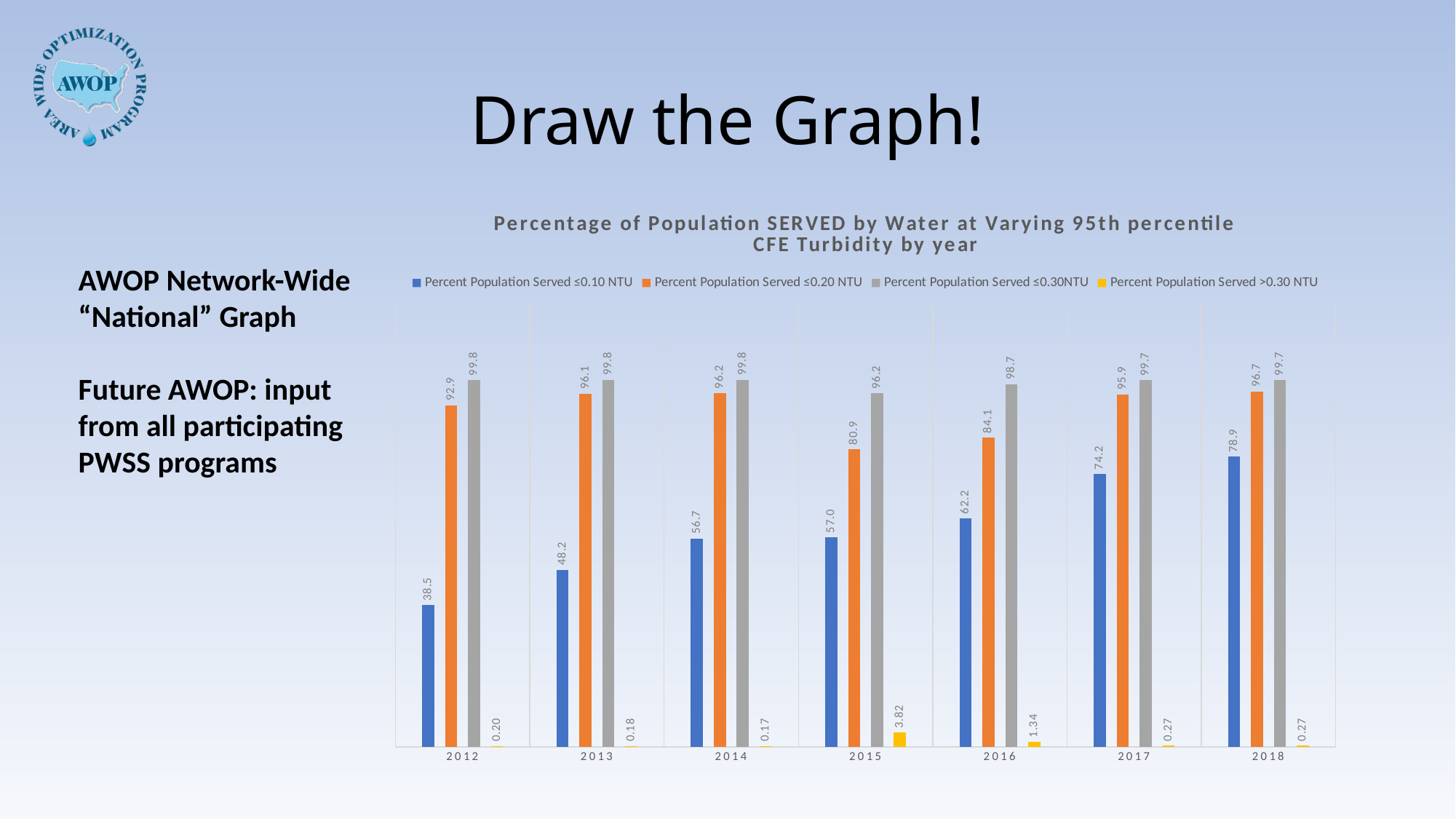
What colour are the bars for Percent Population Served >0.30 NTU? Yellow What kind of chart is shown on the slide? Bar chart Does the Percent Population Served ≤0.10 NTU series rise or fall from 2012 to 2018? Rise Which is larger, the Percent Population Served ≤0.30NTU value in 2015 or in 2016? 2016 What is the value for Percent Population Served ≤0.20 NTU in 2016? 84.1 What is the value for Percent Population Served ≤0.10 NTU in 2012? 38.5 What is the value for Percent Population Served >0.30 NTU in 2015? 3.82 What is the difference between the Percent Population Served ≤0.10 NTU values for 2018 and 2012? 40.4 How many years are shown on the x axis? 7 How many series does the legend list? 4 In which year is the Percent Population Served ≤0.20 NTU value lowest? 2015 In which year is the Percent Population Served ≤0.10 NTU value highest? 2018